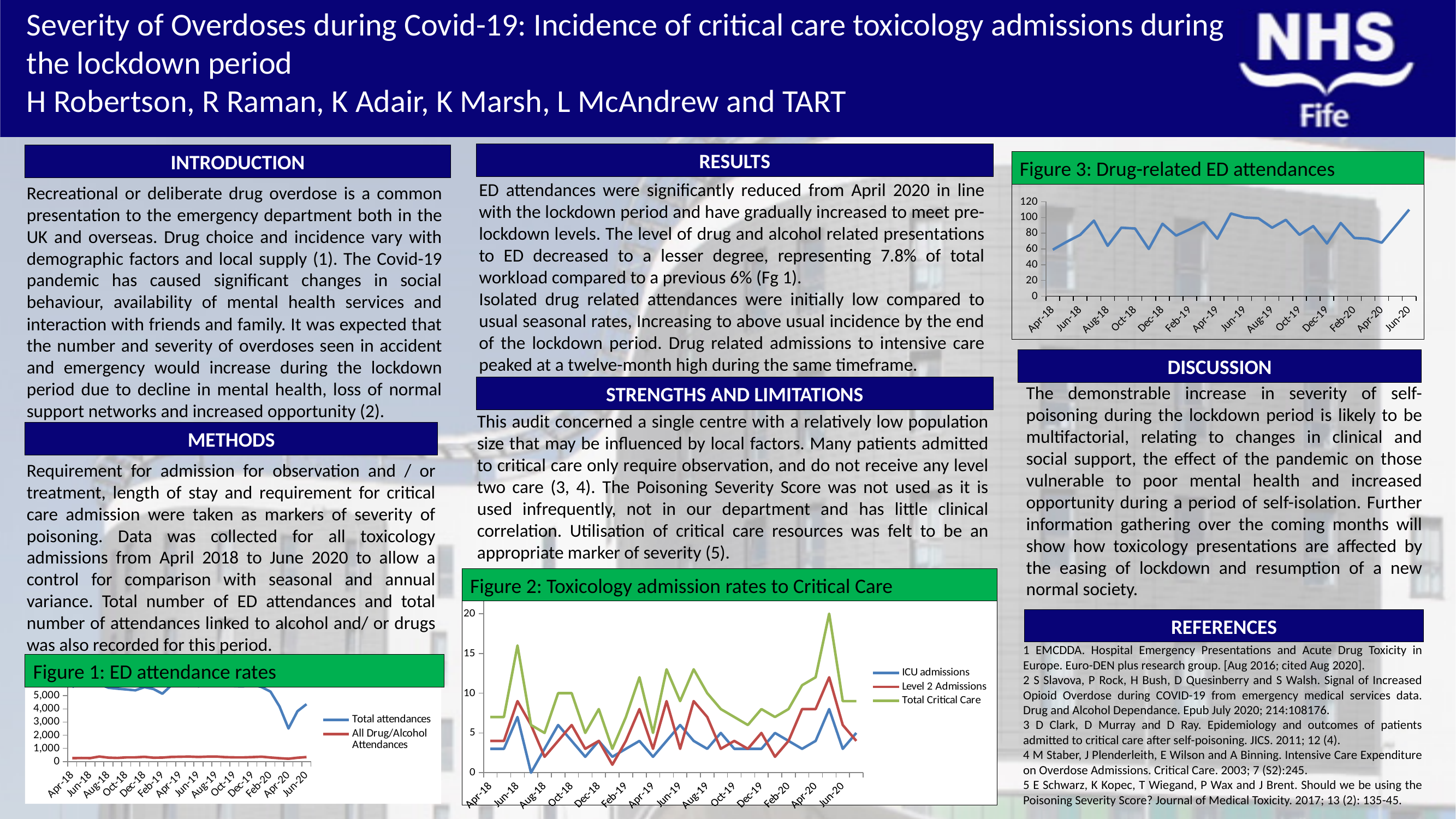
How many series does the legend of Figure 1: ED attendance rates list? 2 In Figure 2: Toxicology admission rates to Critical Care, which series is shown in green? Total Critical Care In Figure 3: Drug-related ED attendances, do the values rise or fall from Apr-20 to Jun-20? rise In Figure 3: Drug-related ED attendances, is the value for Apr-18 greater or less than 80? less How many series does the legend of Figure 2: Toxicology admission rates to Critical Care list? 3 In Figure 1: ED attendance rates, is the value for Total attendances at Apr-20 greater or less than 3,000? less What kind of chart is Figure 2: Toxicology admission rates to Critical Care? line chart In Figure 2: Toxicology admission rates to Critical Care, which is larger at Jun-18: Total Critical Care or ICU admissions? Total Critical Care In Figure 1: ED attendance rates, what are the two legend entries? Total attendances; All Drug/Alcohol Attendances In Figure 3: Drug-related ED attendances, is the value for Jun-20 greater or less than 100? greater In Figure 3: Drug-related ED attendances, which month has the highest value? Jun-20